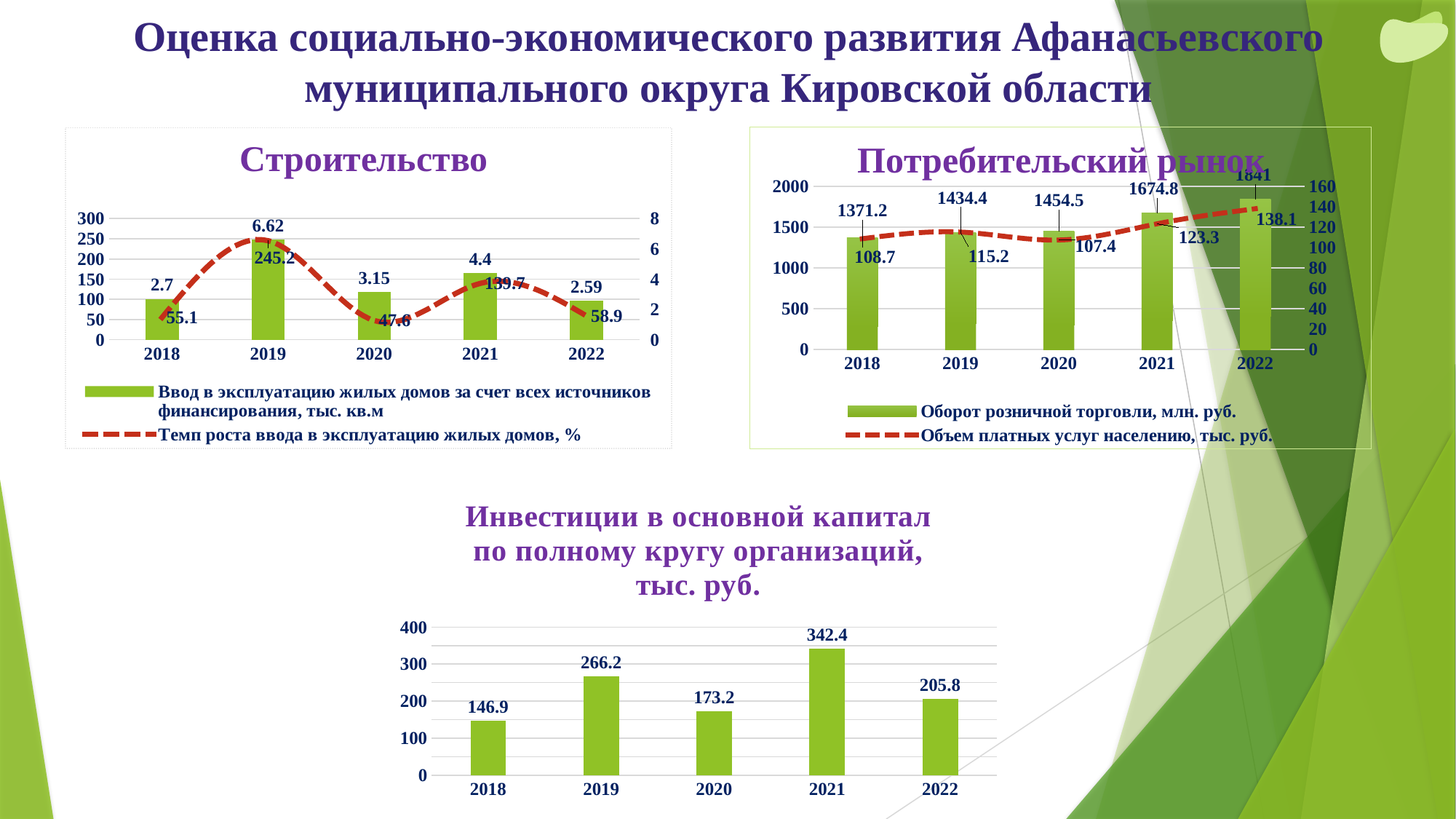
In the 'Потребительский рынок' chart, what is the difference between 'Оборот розничной торговли' in 2021 and 2018? 303.6 In the 'Потребительский рынок' chart, which year has the lowest value for 'Объем платных услуг населению'? 2020 In the 'Инвестиции в основной капитал' chart, what is the value for 2021? 342.4 In the 'Инвестиции в основной капитал' chart, which is larger, the value for 2019 or the value for 2022? 2019 In the 'Потребительский рынок' chart, which year has the highest value for 'Оборот розничной торговли'? 2022 In the 'Строительство' chart, what is the value of 'Темп роста ввода в эксплуатацию жилых домов, %' for 2021? 139.7 In the 'Инвестиции в основной капитал' chart, how many years are shown on the x axis? 5 In the 'Строительство' chart, which year has the lowest value for 'Ввод в эксплуатацию жилых домов'? 2022 In the 'Строительство' chart, what is the value of 'Ввод в эксплуатацию жилых домов' for 2019? 6.62 In the 'Строительство' chart, how many series does the legend list? 2 In the 'Потребительский рынок' chart, what is the value of 'Оборот розничной торговли' for 2020? 1454.5 What kind of chart is the 'Инвестиции в основной капитал' chart? bar chart